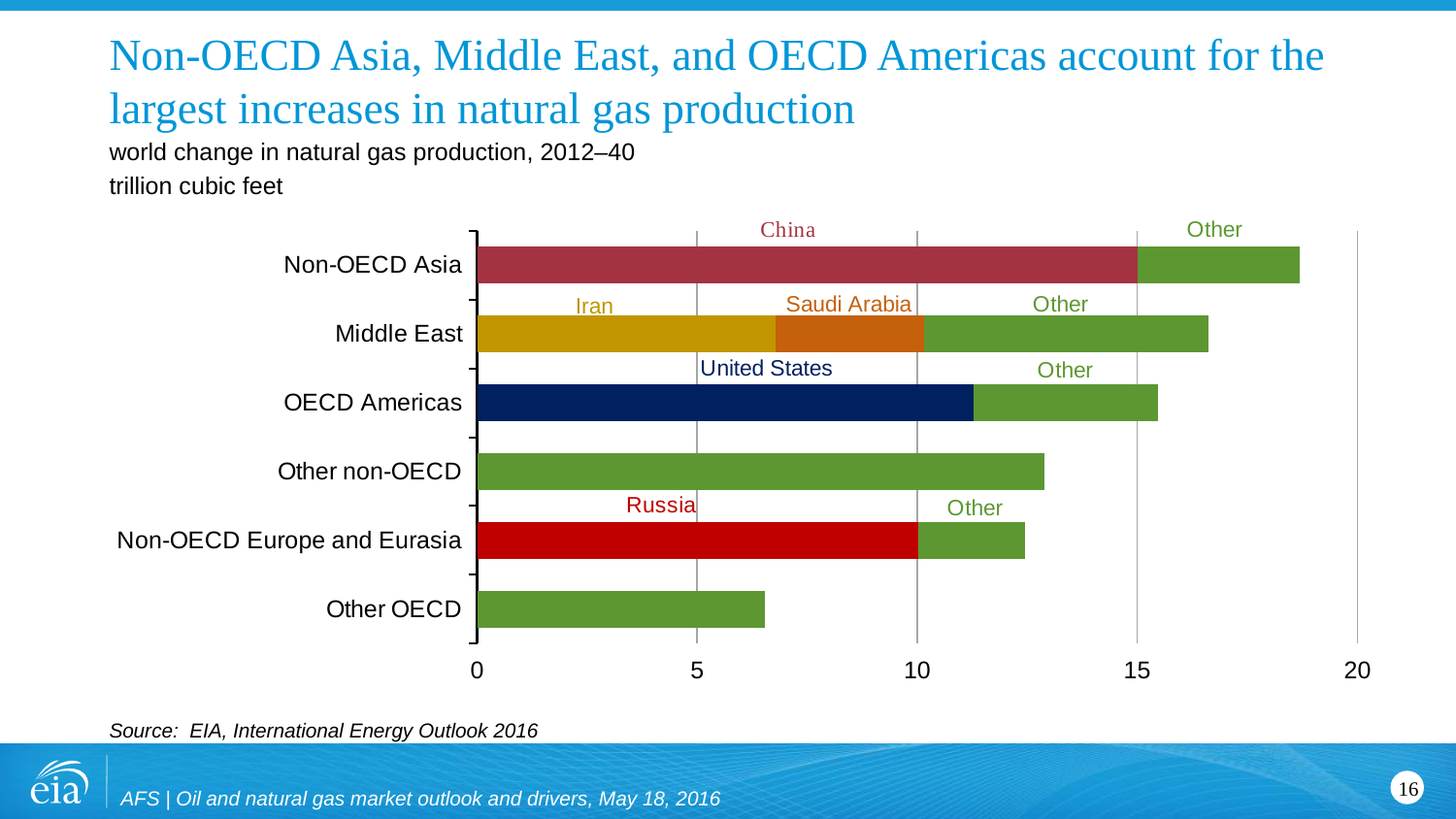
Is the Iran segment of the Middle East bar greater or less than 5? greater Which country is labeled as the main segment of the Non-OECD Europe and Eurasia bar? Russia Is the total value for Non-OECD Asia greater or less than 15? greater Is the total value for Other OECD greater or less than 10? less Which region has the largest total change in natural gas production? Non-OECD Asia Which region has a larger total bar, Middle East or OECD Americas? Middle East Which region has the smallest total change in natural gas production? Other OECD How many regions (categories) are plotted on the chart? 6 What kind of chart is shown on the slide? bar chart What unit is the chart measured in? trillion cubic feet Which country segment is larger within the Middle East bar, Iran or Saudi Arabia? Iran